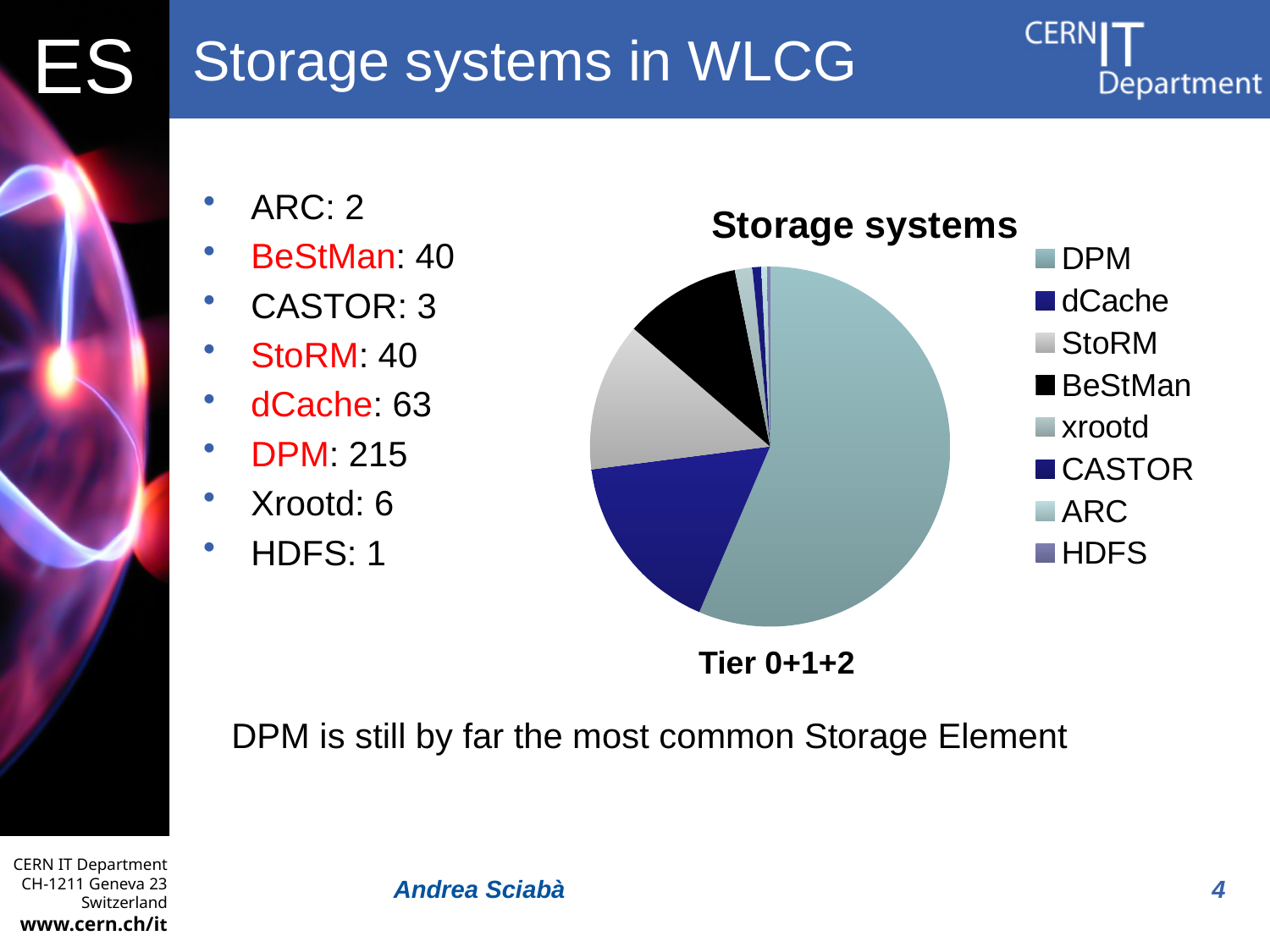
Which storage system has the largest slice in the pie chart? DPM What caption appears below the pie chart? Tier 0+1+2 What is the title of the chart? Storage systems What is the difference between the values for dCache and BeStMan? 23 What is the value for DPM? 215 Which storage system has the smallest slice in the pie chart? HDFS Which has the larger slice, dCache or StoRM? dCache How many storage systems (slices) does the pie chart show? 8 What is the value for StoRM? 40 What is the value for dCache? 63 What is the difference between the values for DPM and dCache? 152 What kind of chart is shown on the slide? pie chart